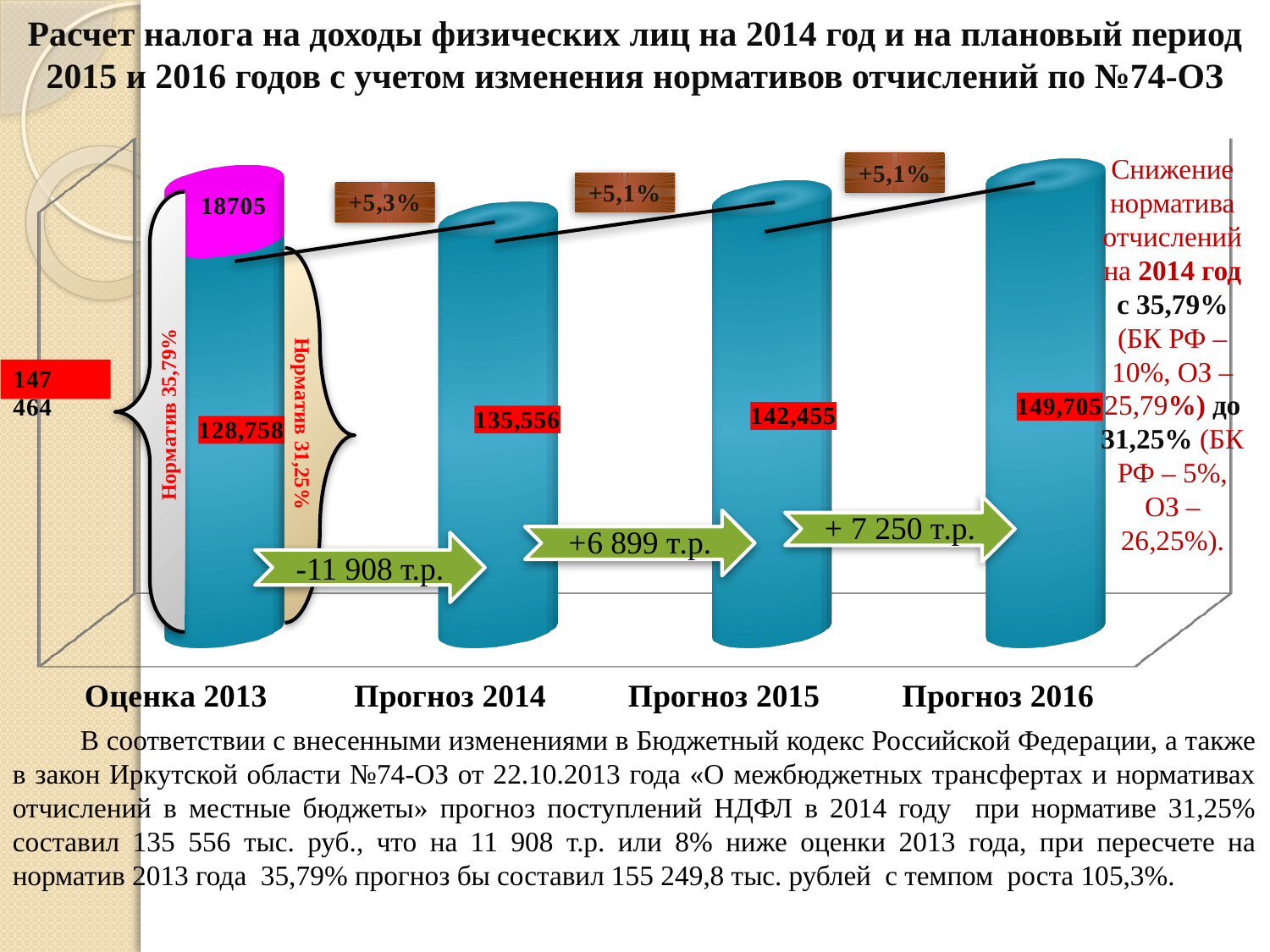
Do the values rise or fall from Прогноз 2014 to Прогноз 2016? rise How many categories (bars) are shown on the chart? 4 What is the difference between the values for Прогноз 2016 and Прогноз 2015? 7,250 What is the value shown for Прогноз 2016? 149,705 Which is larger, the value for Прогноз 2015 or for Прогноз 2014? Прогноз 2015 What value is labelled on the magenta top segment of the Оценка 2013 bar? 18705 What is the value shown for Прогноз 2014? 135,556 What is the difference between the values for Прогноз 2015 and Прогноз 2014? 6,899 What value is labelled on the blue part of the Оценка 2013 bar? 128,758 What percentage change is labelled between Прогноз 2014 and Прогноз 2015? +5,1% What is the value shown for Прогноз 2015? 142,455 What is the total value shown for the Оценка 2013 bar? 147 464